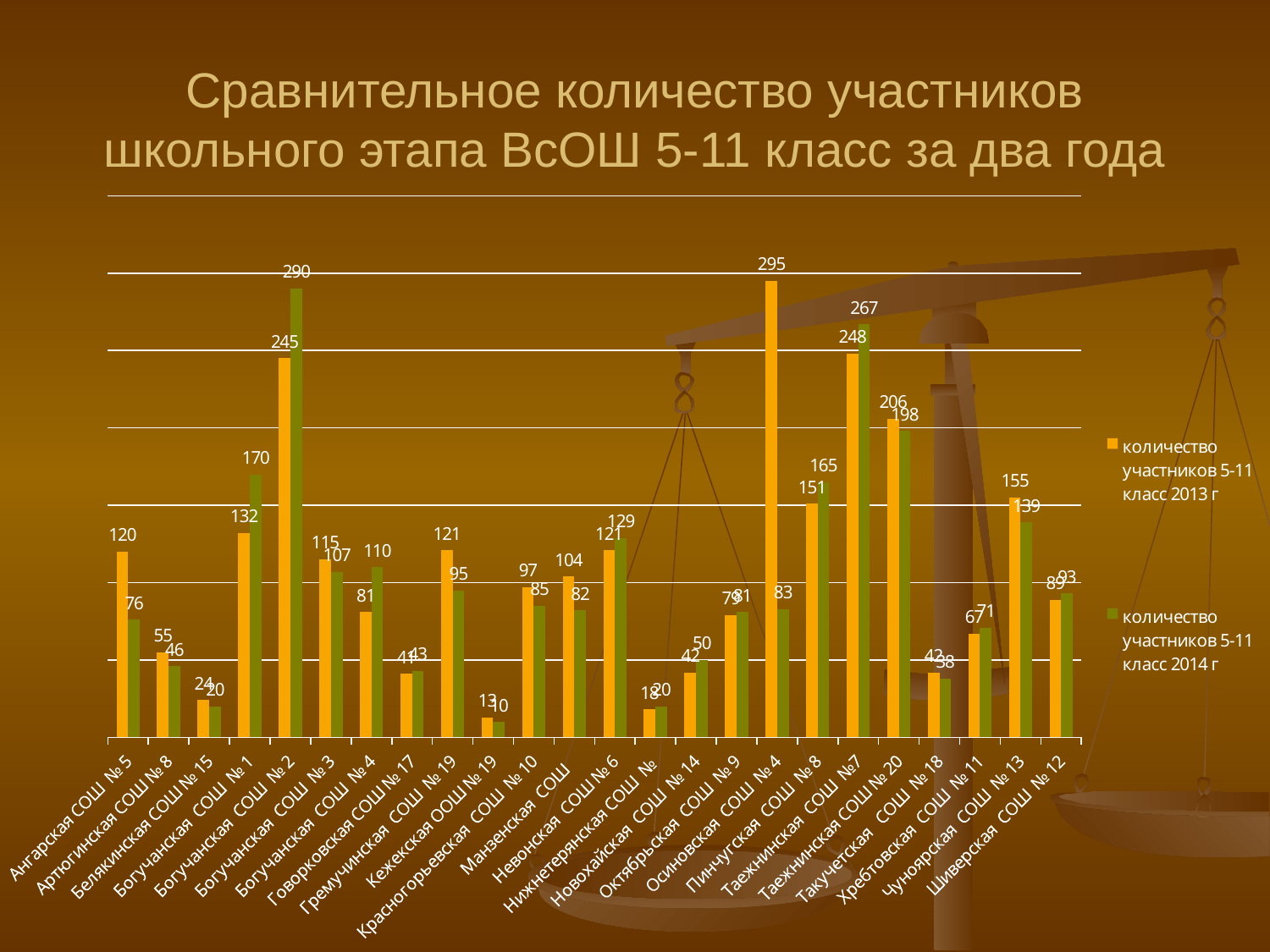
Which school has the highest value in the 2013 series? Осиновская СОШ № 4 What type of chart is shown on the slide? bar chart Which school has the highest value in the 2014 series? Богучанская СОШ № 2 Which school has the lowest value in the 2013 series? Кежекская ООШ № 19 What is the number of participants for Богучанская СОШ № 2 in 2014 (количество участников 5-11 класс 2014 г)? 290 What is the 2014 value for Таежнинская СОШ №7? 267 How many series does the legend list? 2 How many schools (categories) are shown on the x axis? 24 For Ангарская СОШ № 5, which year has the larger number of participants, 2013 or 2014? 2013 What colour represents the 2013 series (количество участников 5-11 класс 2013 г)? orange